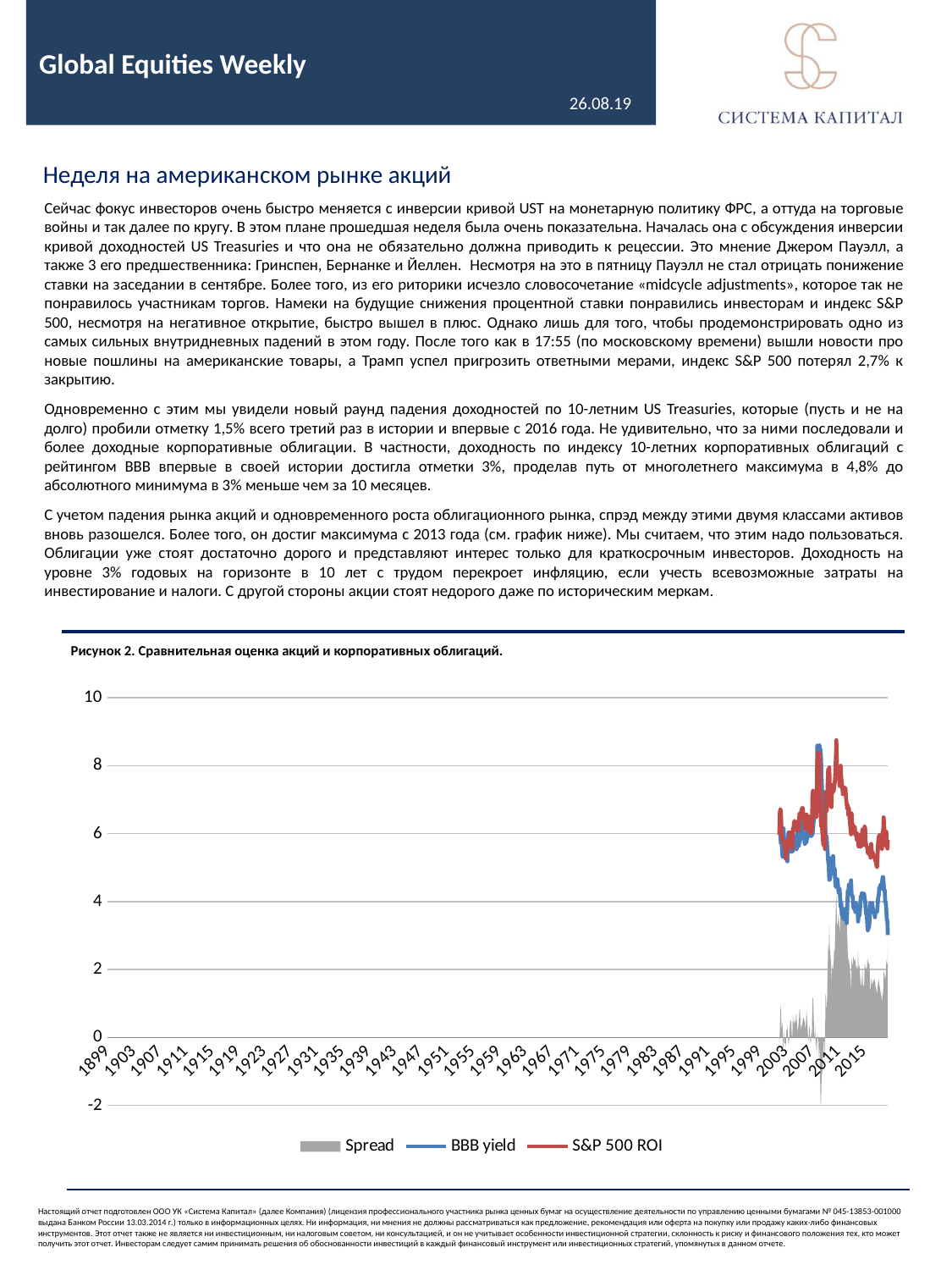
How many series does the legend of the chart list? 3 What is the highest value shown on the chart's vertical axis? 10 What is the first year label on the chart's horizontal axis? 1899 Is the final value of the BBB yield series (at the right end of the chart) greater or less than 4? less At the right end of the chart, which is larger: S&P 500 ROI or BBB yield? S&P 500 ROI Does the BBB yield series rise or fall between its 2009 peak and the right end of the chart? fall What kind of chart is shown in Рисунок 2? combination area and line chart What is the lowest value shown on the chart's vertical axis? -2 Is the peak value of the S&P 500 ROI series greater or less than 8? greater What are the three series named in the chart legend? Spread, BBB yield, S&P 500 ROI What is the last year label on the chart's horizontal axis? 2015 Which series in the chart is drawn in red? S&P 500 ROI